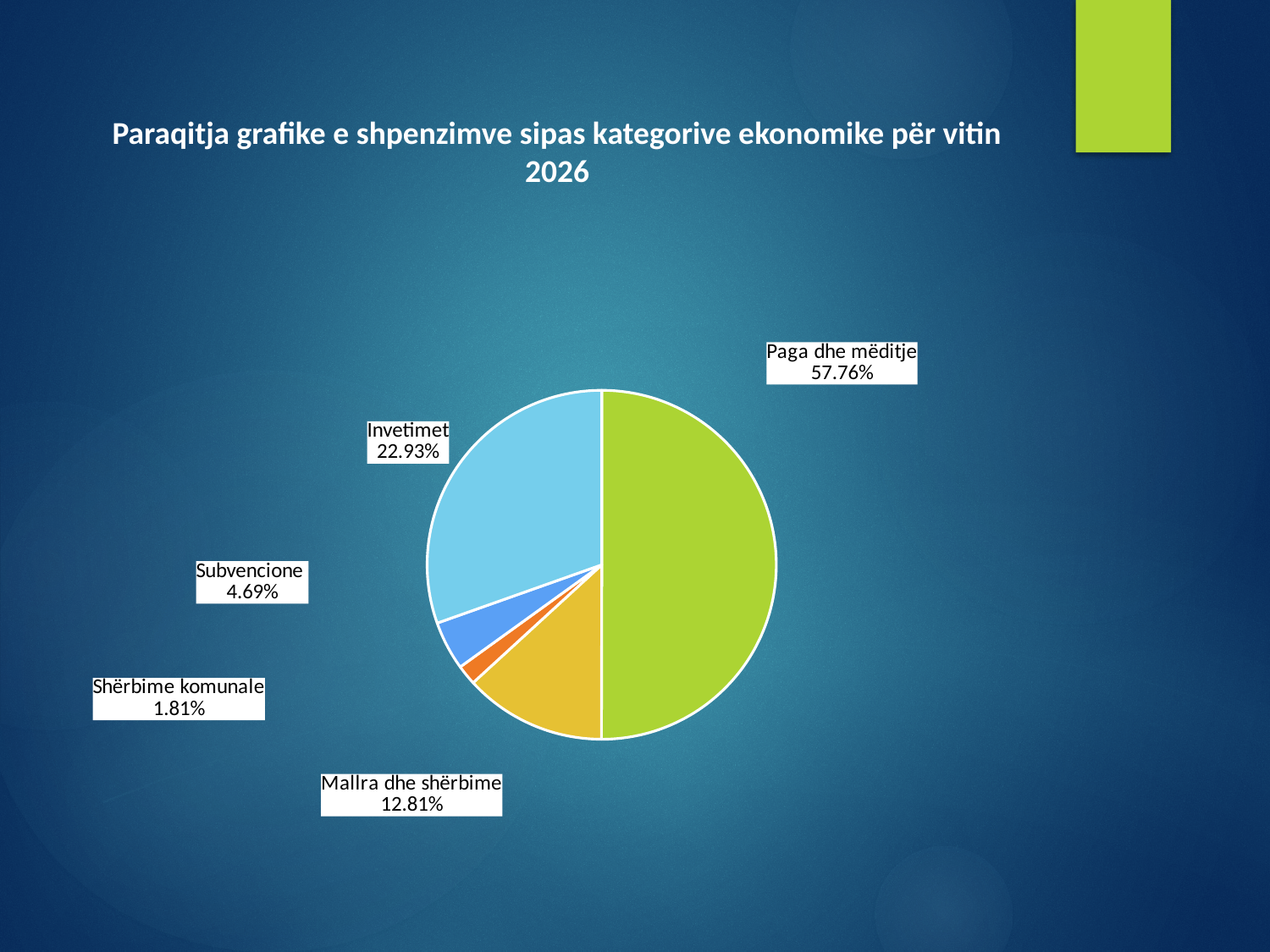
What is the title of the chart? Paraqitja grafike e shpenzimve sipas kategorive ekonomike për vitin 2026 How many categories are shown in the pie chart? 5 Which category has the largest slice of the pie? Paga dhe mëditje What is the difference between the shares of Paga dhe mëditje and Invetimet? 34.83% What is the value shown for Shërbime komunale? 1.81% What is the value shown for Subvencione? 4.69% What share of the pie does Paga dhe mëditje represent? 57.76% Which category has the smallest slice of the pie? Shërbime komunale What is the value shown for Invetimet? 22.93% What kind of chart is shown on the slide? pie chart What is the value shown for Mallra dhe shërbime? 12.81% Which is larger, Invetimet or Mallra dhe shërbime? Invetimet